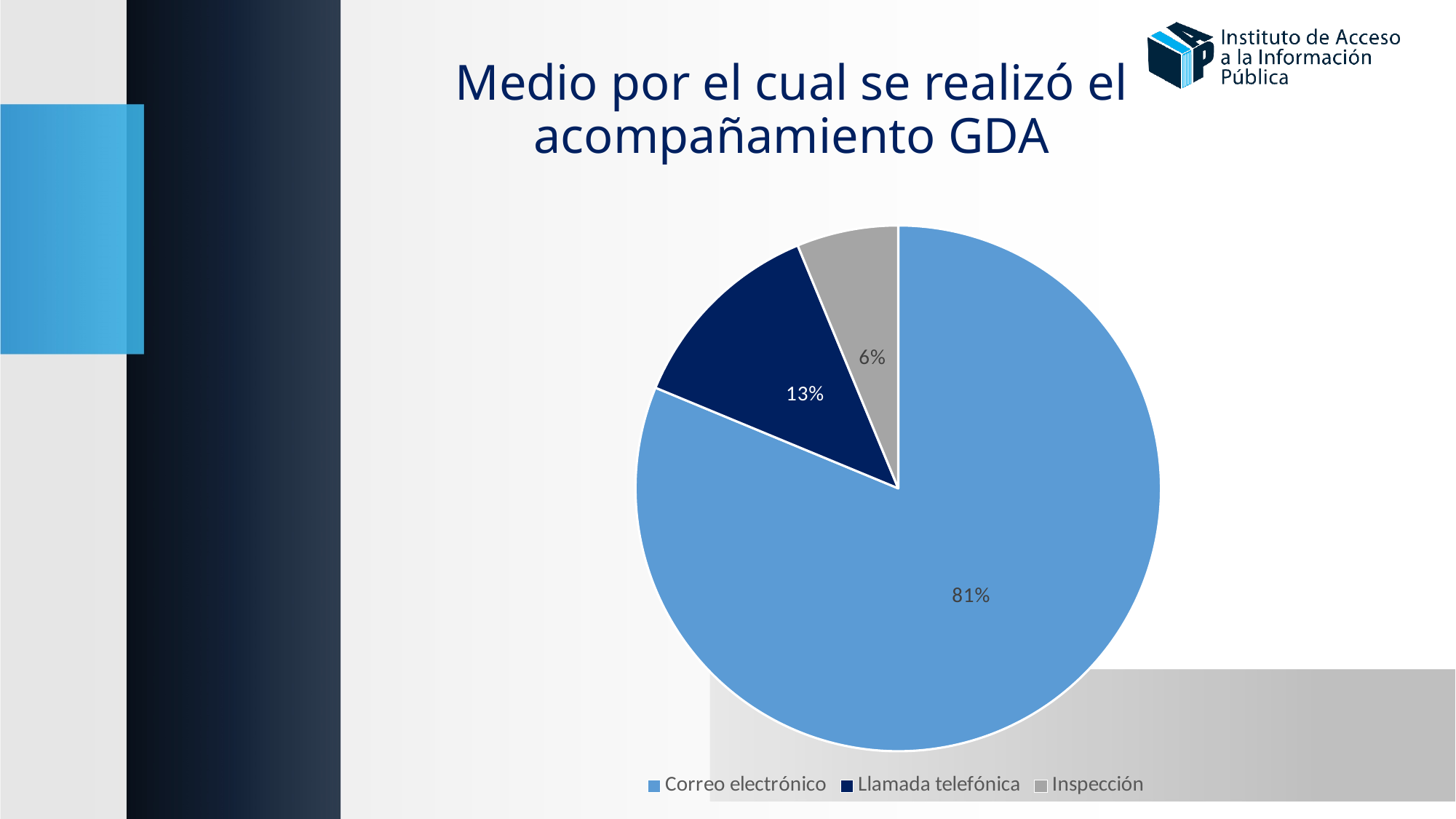
What share of the pie does Correo electrónico represent? 81% What share of the pie does Llamada telefónica represent? 13% How many categories are shown in the pie chart? 3 What is the difference in percentage points between Llamada telefónica and Inspección? 7 Which category has the smallest slice of the pie? Inspección What colour is the slice for Llamada telefónica? Dark navy blue Which is larger, the share for Llamada telefónica or the share for Inspección? Llamada telefónica What is the title of the chart? Medio por el cual se realizó el acompañamiento GDA What is the difference in percentage points between Correo electrónico and Llamada telefónica? 68 What share of the pie does Inspección represent? 6% Which category has the largest slice of the pie? Correo electrónico What kind of chart is shown on the slide? Pie chart